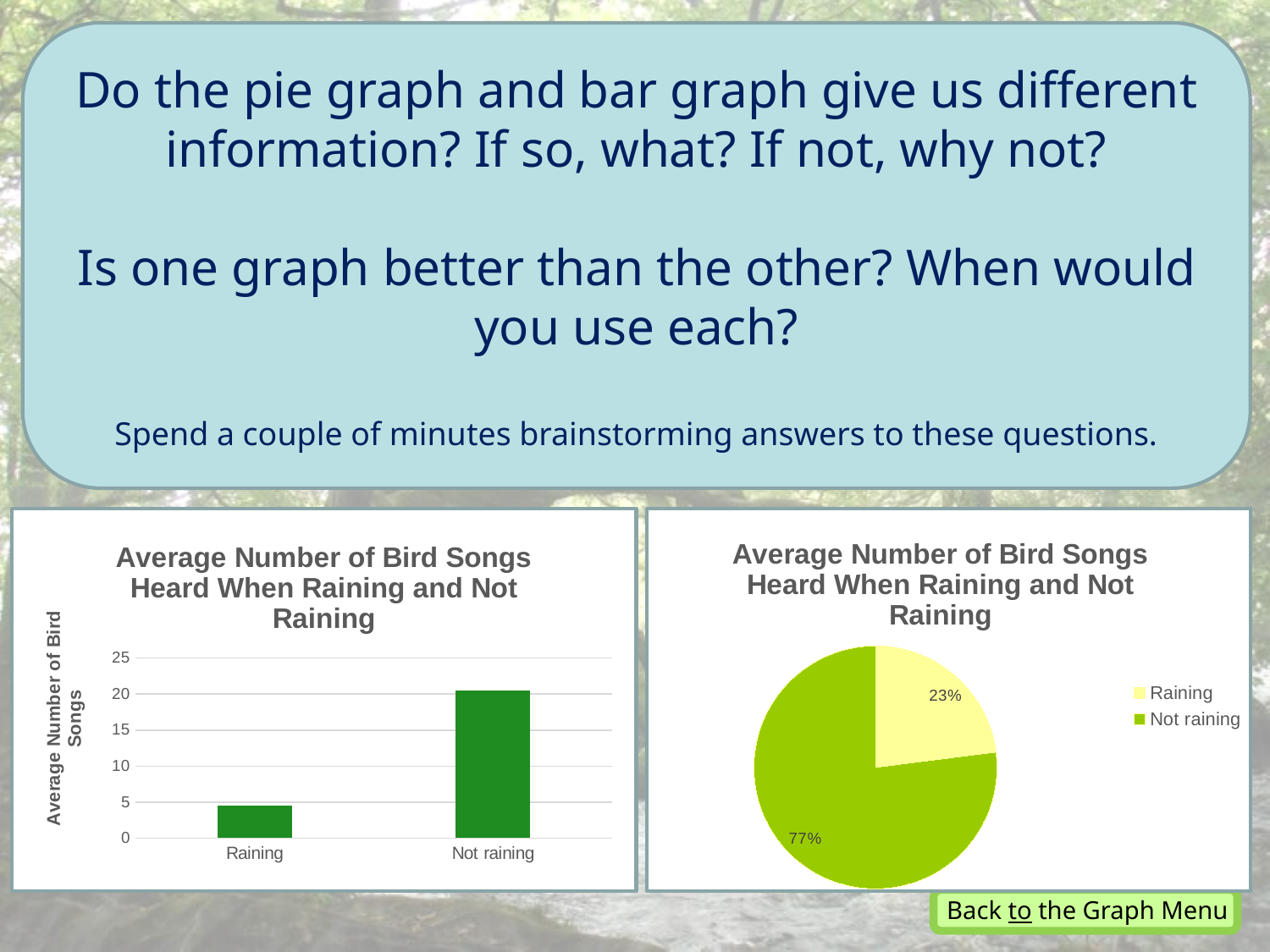
In the bar chart on the left, which category has the lowest value? Raining In the bar chart on the left, which category has the highest value? Not raining What kind of chart is the chart on the left of the slide? bar chart How many categories are shown in the bar chart on the left? 2 In the pie chart on the right, what share is labelled for Not raining? 77% How many entries does the legend of the pie chart on the right list? 2 In the pie chart on the right, what is the difference between the Not raining share and the Raining share? 54% In the pie chart on the right, what share is labelled for Raining? 23% What is the y-axis label of the bar chart on the left? Average Number of Bird Songs What kind of chart is the chart on the right of the slide? pie chart